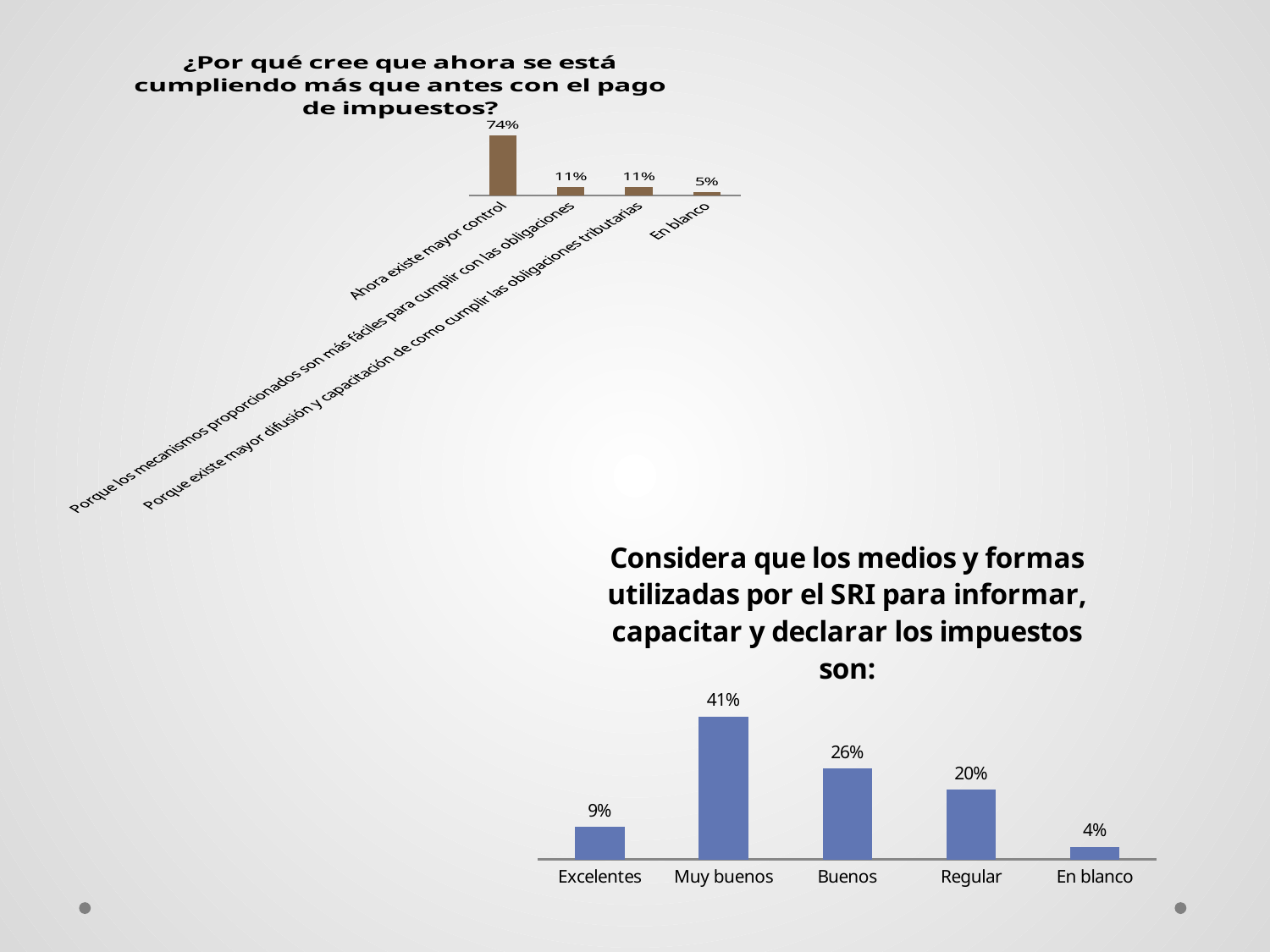
In the bottom-right chart ("Considera que los medios y formas utilizadas por el SRI..."), which is larger, Excelentes or Regular? Regular In the top-left chart ("¿Por qué cree que ahora se está cumpliendo más que antes con el pago de impuestos?"), what is the value for "Ahora existe mayor control"? 74% In the top-left chart ("¿Por qué cree que ahora se está cumpliendo más que antes con el pago de impuestos?"), which category has the highest value? Ahora existe mayor control In the bottom-right chart ("Considera que los medios y formas utilizadas por el SRI..."), which category has the lowest value? En blanco In the top-left chart ("¿Por qué cree que ahora se está cumpliendo más que antes con el pago de impuestos?"), what is the value for "En blanco"? 5% What kind of chart is the bottom-right chart ("Considera que los medios y formas utilizadas por el SRI...")? Bar chart In the bottom-right chart ("Considera que los medios y formas utilizadas por el SRI..."), what is the difference between Muy buenos and Buenos? 15% In the bottom-right chart ("Considera que los medios y formas utilizadas por el SRI..."), how many categories are shown? 5 In the bottom-right chart ("Considera que los medios y formas utilizadas por el SRI..."), what is the value for Muy buenos? 41% In the bottom-right chart ("Considera que los medios y formas utilizadas por el SRI..."), which category has the highest value? Muy buenos In the bottom-right chart ("Considera que los medios y formas utilizadas por el SRI..."), what is the value for Regular? 20% In the top-left chart ("¿Por qué cree que ahora se está cumpliendo más que antes con el pago de impuestos?"), how many categories are shown? 4